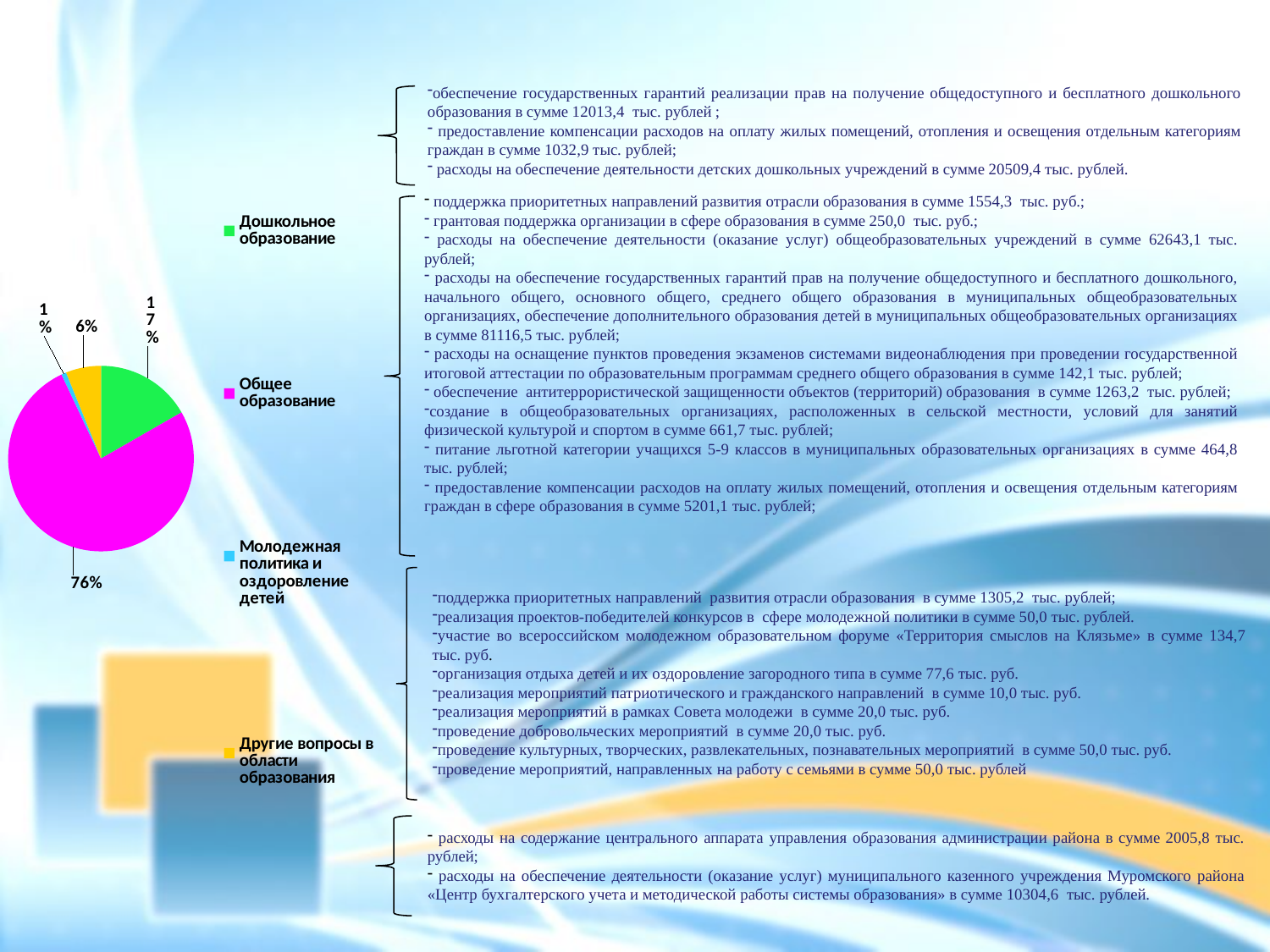
Which category has the largest slice of the pie? Общее образование How many entries does the legend of the pie chart list? 4 What share of the pie does Другие вопросы в области образования take? 6% Which is larger: the share for Дошкольное образование or the share for Другие вопросы в области образования? Дошкольное образование What share of the pie does Общее образование take? 76% Which category has the smallest slice of the pie? Молодежная политика и оздоровление детей What is the difference in percentage points between Общее образование and Дошкольное образование? 59 What share of the pie does Молодежная политика и оздоровление детей take? 1% What kind of chart is shown on the slide? pie chart What colour is the slice for Общее образование? magenta How many slices does the pie chart have? 4